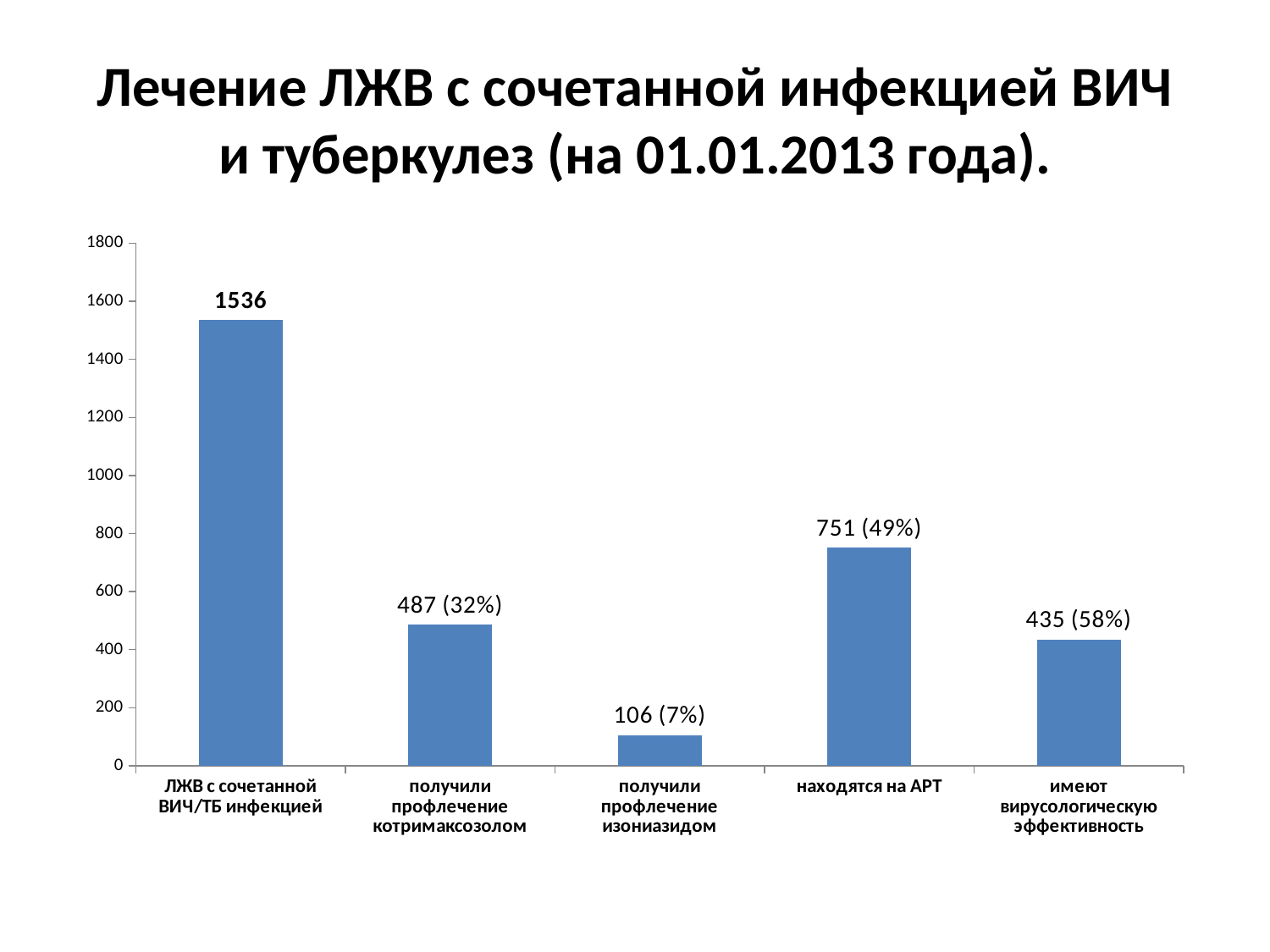
What kind of chart is shown on the slide? bar chart What is the title of the slide? Лечение ЛЖВ с сочетанной инфекцией ВИЧ и туберкулез (на 01.01.2013 года). Is the value for 'находятся на АРТ' greater or less than 800? less What is the difference between the values for 'находятся на АРТ' and 'получили профлечение котримаксозолом'? 264 How many categories are shown on the x axis? 5 Which is larger: the value for 'получили профлечение котримаксозолом' or the value for 'имеют вирусологическую эффективность'? получили профлечение котримаксозолом What is the value for the category 'ЛЖВ с сочетанной ВИЧ/ТБ инфекцией'? 1536 What data label is shown for the category 'имеют вирусологическую эффективность'? 435 (58%) Which category has the lowest value? получили профлечение изониазидом What data label is shown for the category 'находятся на АРТ'? 751 (49%) What data label is shown for the category 'получили профлечение изониазидом'? 106 (7%) Which category has the highest value? ЛЖВ с сочетанной ВИЧ/ТБ инфекцией